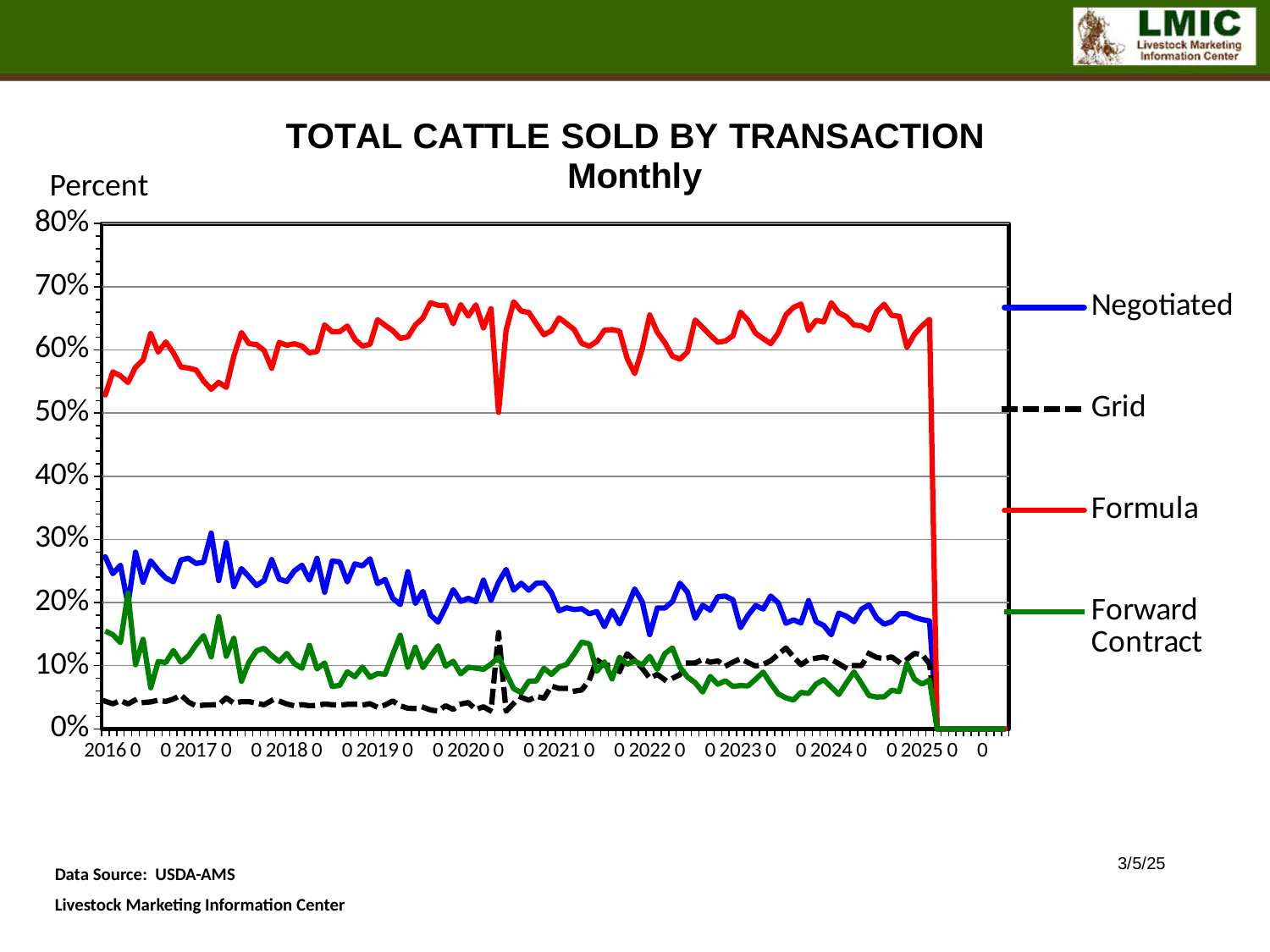
How many series does the legend list? 4 Does the Grid series generally rise or fall from 2016 to 2024? rise Which series has the highest values across the chart? Formula What label is shown on the vertical axis of the chart? Percent What is the title of the chart? TOTAL CATTLE SOLD BY TRANSACTION Monthly Is the value for Negotiated in 2024 greater or less than 30%? less Is the value for Forward Contract in 2022 greater or less than 20%? less Is the value for Grid in 2016 greater or less than 10%? less Which is larger in 2023, the Formula value or the Negotiated value? Formula Does the Negotiated series generally rise or fall from 2016 to 2024? fall What kind of chart is shown on the slide? line chart